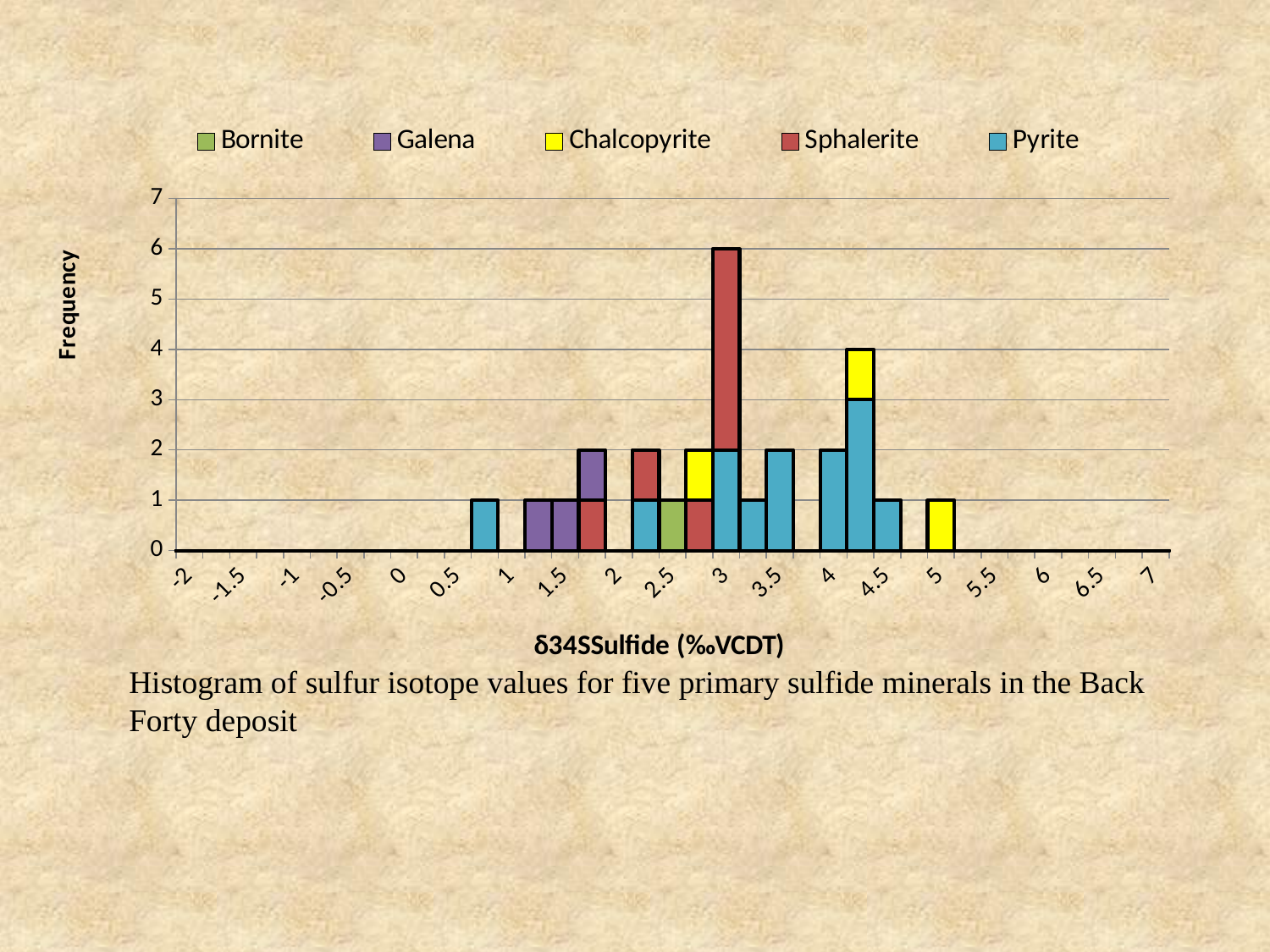
Which minerals are listed in the legend? Bornite, Galena, Chalcopyrite, Sphalerite, Pyrite Which is taller: the stacked bar topped by Sphalerite near 3 or the stacked bar topped by Chalcopyrite near 4.5? the bar topped by Sphalerite near 3 Is the tallest stacked bar greater or less than 5? greater What is the total height (frequency) of the tallest stacked bar? 6 What is the difference in total height between the tallest stacked bar (6) and the second tallest stacked bar (4)? 2 What is the total height of the stacked bar that has a Chalcopyrite segment on top of a Pyrite segment reaching 3? 4 What is the label of the vertical axis? Frequency What is the highest value shown on the Frequency axis? 7 Which series forms the top segment of the tallest stacked bar? Sphalerite Are there any bars plotted at negative δ34S values on the x axis? No What kind of chart is shown on the slide? bar chart How many series does the legend list? 5